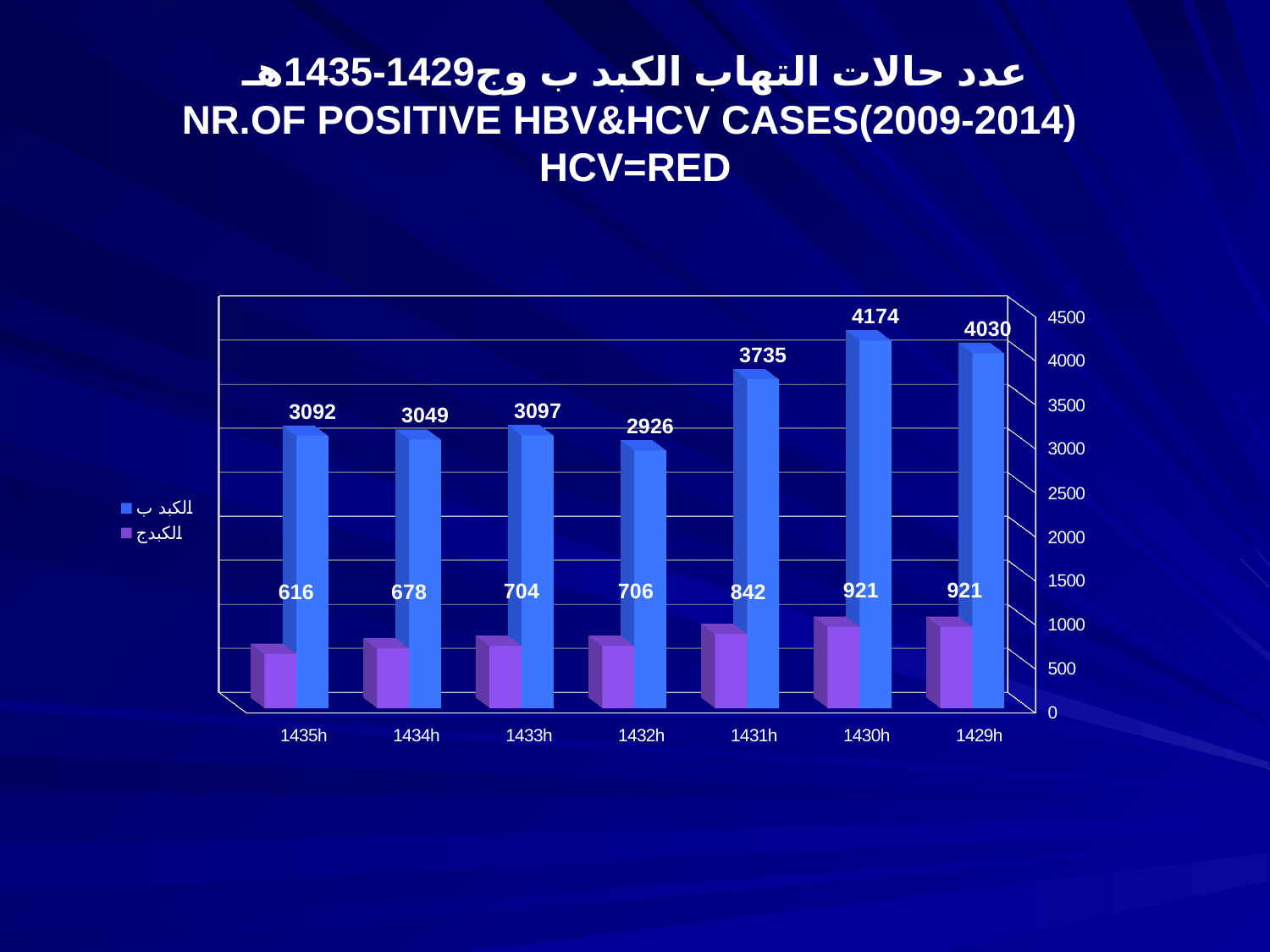
Which is larger, the blue bar for 1431h or the blue bar for 1433h? 1431h What is the value of the blue bar (الكبد ب) for 1435h? 3092 What is the difference between the blue bar values for 1430h and 1429h? 144 Which year has the lowest blue bar (الكبد ب)? 1432h What is the value of the blue bar (الكبد ب) for 1430h? 4174 How many series does the legend list? 2 What kind of chart is shown on the slide? Bar chart Which year has the highest blue bar (الكبد ب)? 1430h What is the value of the purple bar (الكبدج) for 1432h? 706 Which year has the lowest purple bar (الكبدج)? 1435h How many years are shown on the x axis? 7 What is the difference between the purple bar values for 1431h and 1435h? 226